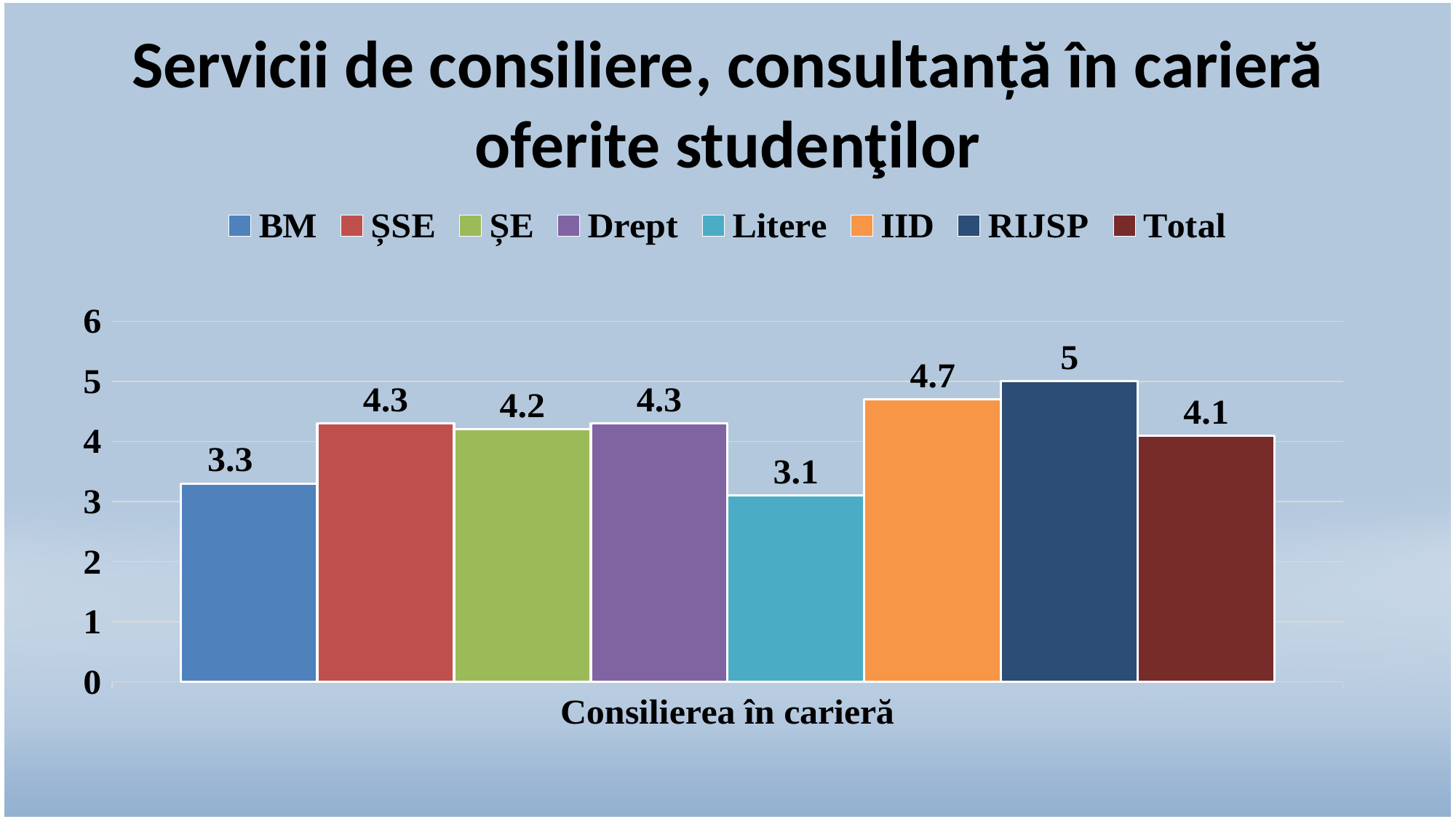
Which is larger, the value for IID or the value for ȘE? IID What is the value for IID? 4.7 What is the difference between the values for RIJSP and BM? 1.7 How many series does the legend list? 8 What is the value for Litere? 3.1 What is the value for Total? 4.1 What is the value for BM? 3.3 What is the label on the x axis of the chart? Consilierea în carieră Which series has the highest value? RIJSP Is the value for Drept greater or less than 4? greater Which series has the lowest value? Litere What kind of chart is shown on the slide? bar chart